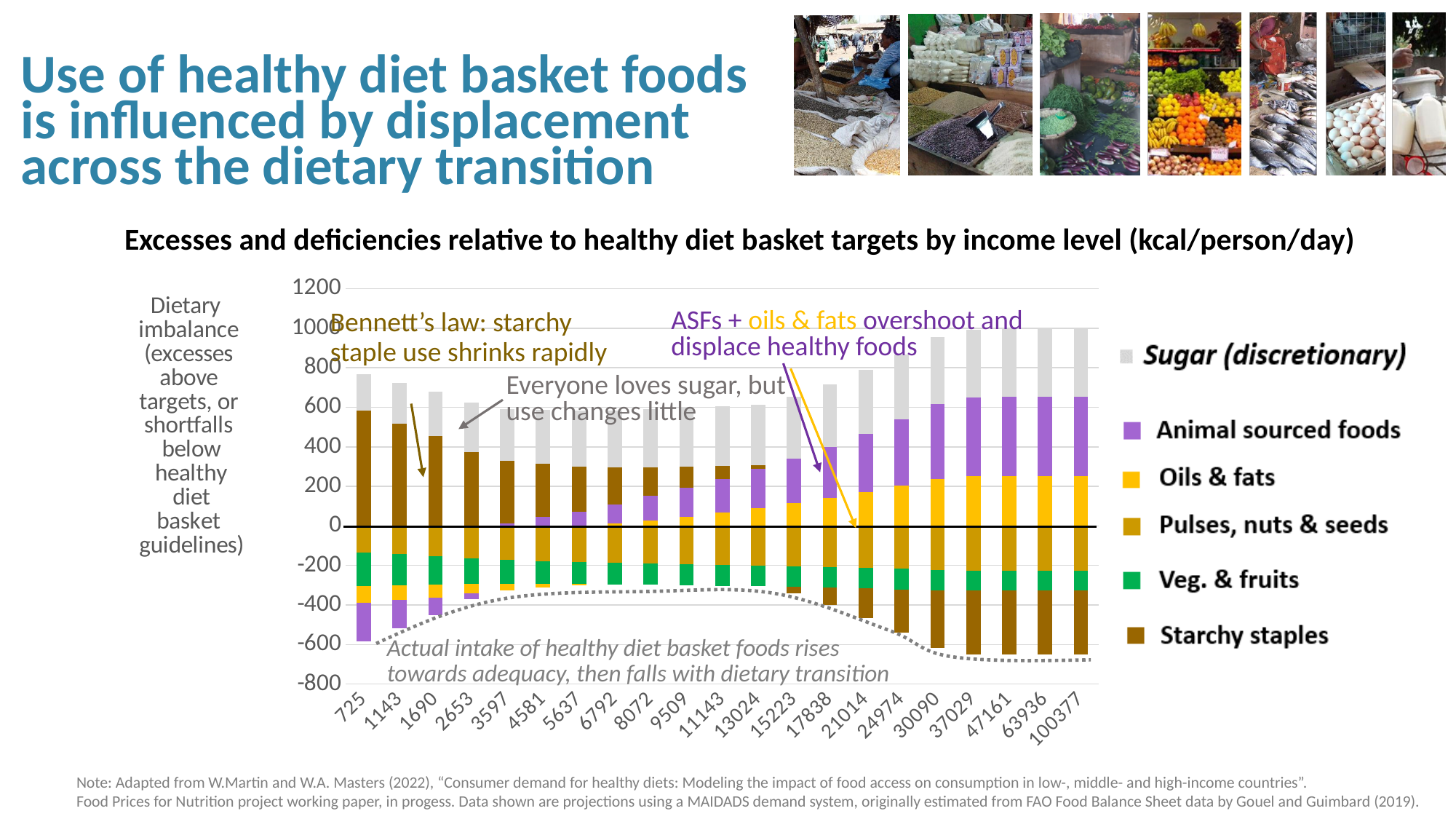
What kind of chart is shown on the slide? Stacked bar chart How many income levels (categories) are shown along the x axis of the chart? 21 Is the Starchy staples value for income level 725 greater or less than 400? greater What is the title of the chart? Excesses and deficiencies relative to healthy diet basket targets by income level (kcal/person/day) Which has the taller positive stack: income level 725 or income level 100377? 100377 Is the bottom of the negative stack for income level 725 greater or less than -400? less How many series does the chart's legend list? 6 Is the top of the positive stack for income level 725 greater or less than 600? greater Does the Animal sourced foods segment rise or fall as income level increases along the x axis? rise Does the positive Starchy staples segment rise or fall as income level increases from 725 to 8072? fall Which series in the legend is shown in purple? Animal sourced foods